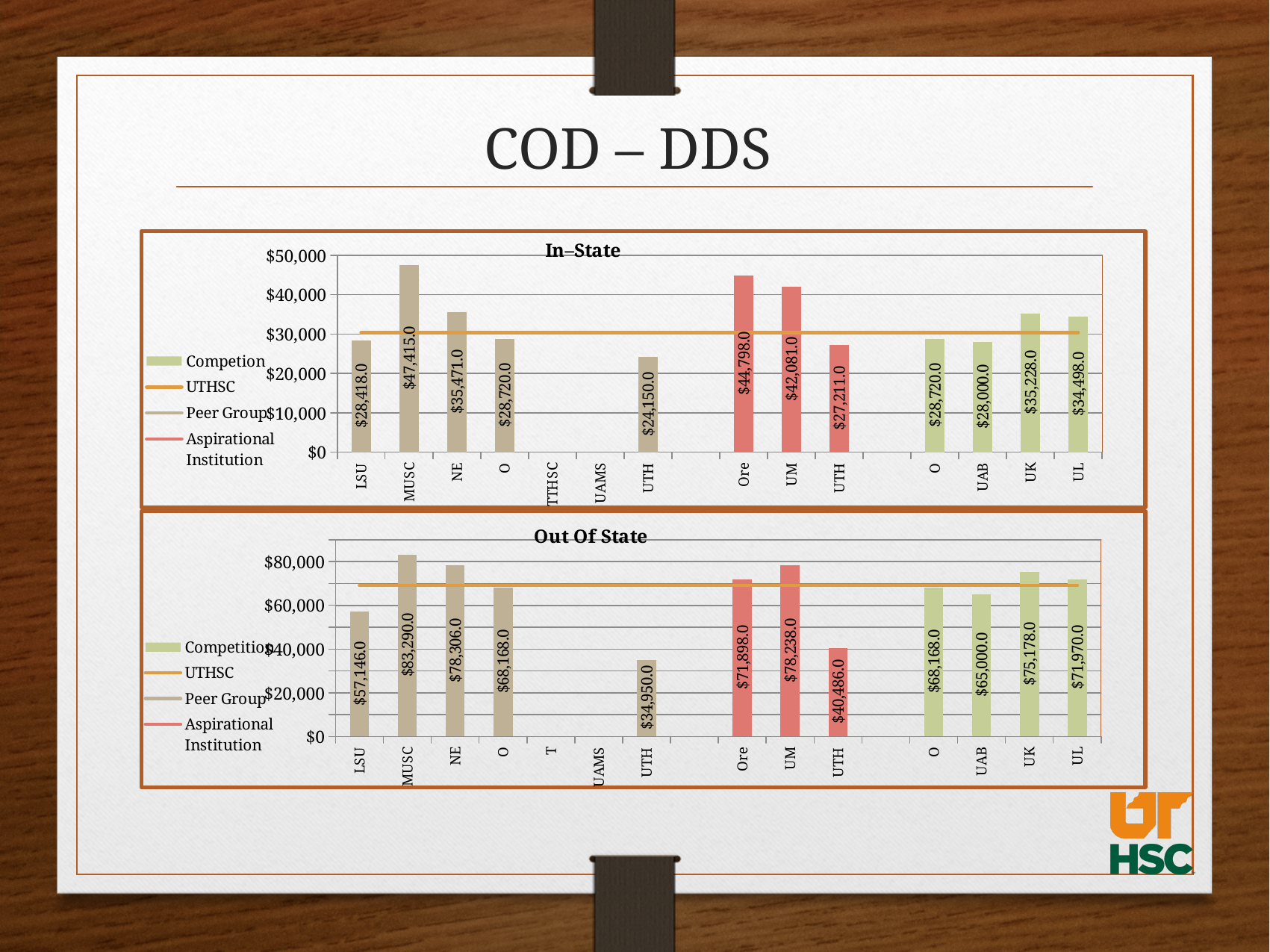
In the In–State chart, which institution has the highest value? MUSC What kind of chart is the Out Of State chart? Bar chart In the In–State chart, what is the value for UK? $35,228.0 In the In–State chart, what is the difference between the values for UK and UL? $730.0 In the In–State chart, which is larger, the value for Ore or the value for UM? Ore In the In–State chart, what is the value for the Peer Group bar labelled UTH? $24,150.0 In the Out Of State chart, which institution has the highest value? MUSC In the Out Of State chart, what is the value for the Peer Group bar labelled UTH? $34,950.0 In the In–State chart, what is the value for MUSC? $47,415.0 In the Out Of State chart, what is the value for UAB? $65,000.0 In the Out Of State chart, what is the difference between the values for MUSC and NE? $4,984.0 How many series does the legend of the In–State chart list? 4